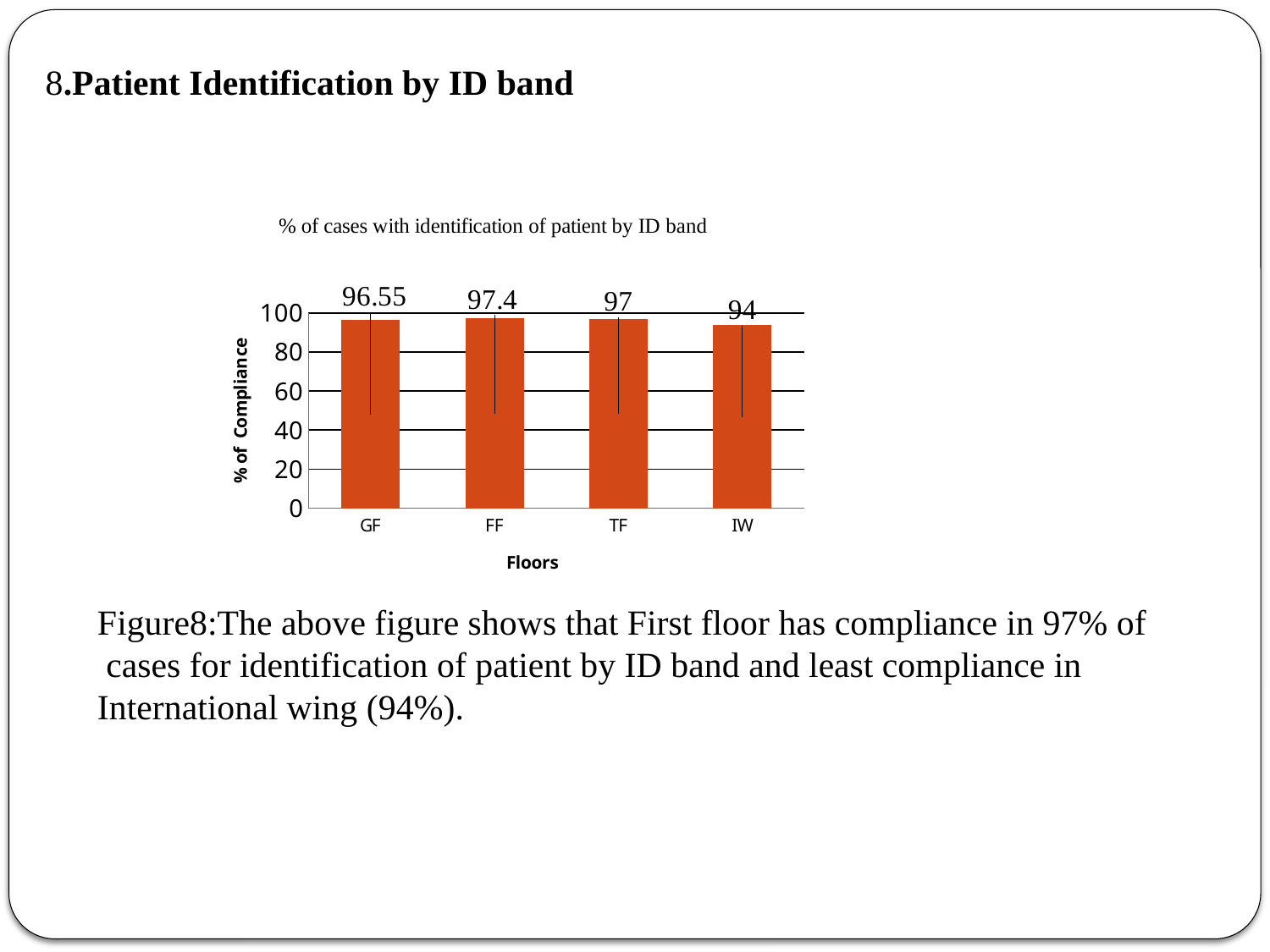
What is the value for FF? 97.4 What is the difference between the values for GF and IW? 2.55 How many floors are shown on the x axis? 4 What is the label of the y axis? % of Compliance Which floor has the highest value? FF Which is larger, the value for GF or the value for IW? GF What is the value for IW? 94 What is the value for GF? 96.55 What is the difference between the values for FF and IW? 3.4 Which floor has the lowest value? IW What is the value for TF? 97 What kind of chart is shown on the slide? Bar chart